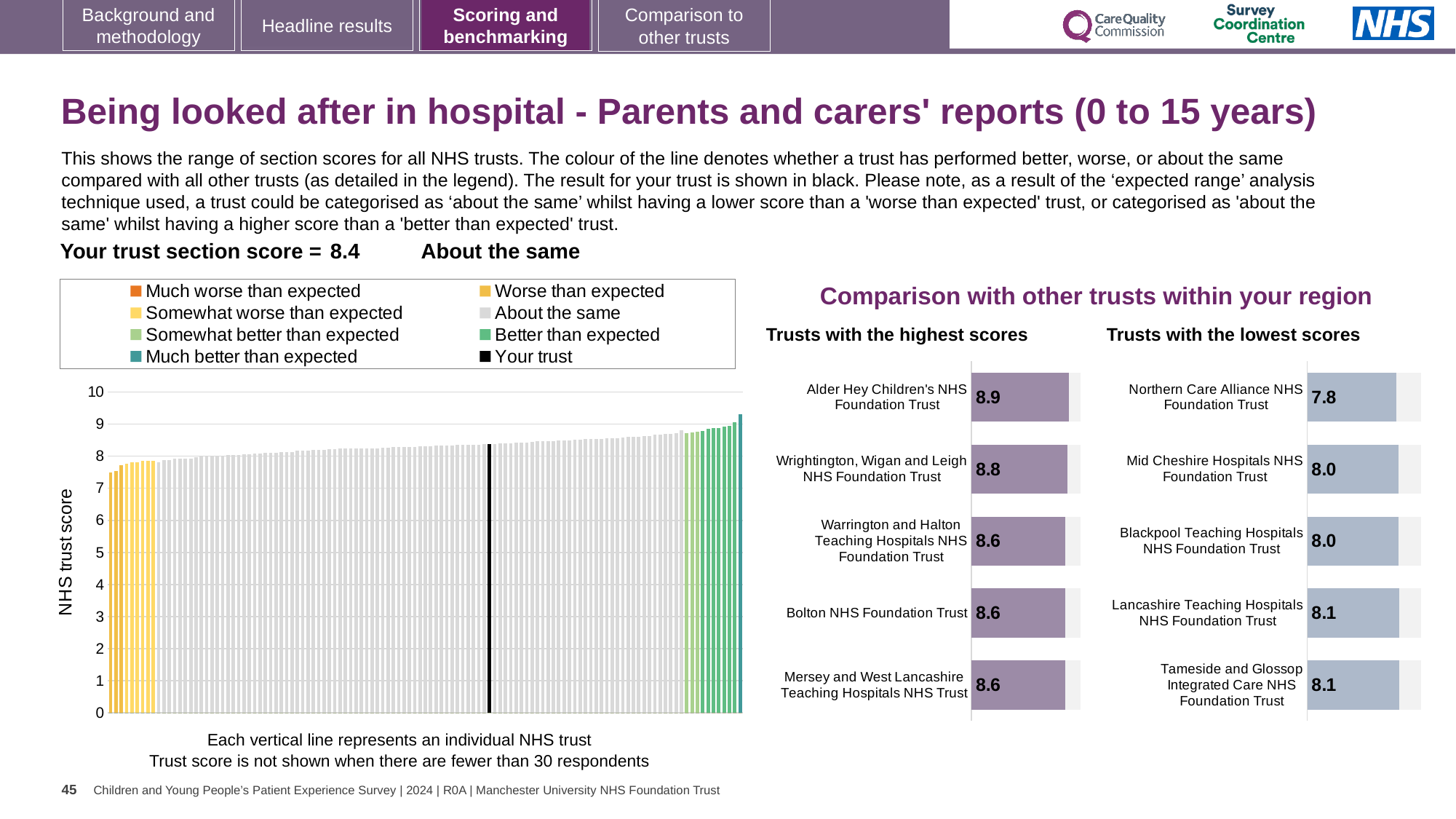
In the 'Trusts with the lowest scores' chart, what is the score for Northern Care Alliance NHS Foundation Trust? 7.8 In the main NHS trust score chart on the left, what is the section score for your trust (shown in black)? 8.4 What kind of chart is the main NHS trust score chart on the left of the slide? Bar chart How many entries does the legend of the main NHS trust score chart on the left list? 8 In the 'Trusts with the lowest scores' chart, which trust has the lowest score? Northern Care Alliance NHS Foundation Trust In the 'Trusts with the highest scores' chart, what is the score for Alder Hey Children's NHS Foundation Trust? 8.9 In the 'Trusts with the highest scores' chart, which has the larger score: Wrightington, Wigan and Leigh NHS Foundation Trust or Bolton NHS Foundation Trust? Wrightington, Wigan and Leigh NHS Foundation Trust In the 'Trusts with the highest scores' chart, what is the difference between the scores of Alder Hey Children's NHS Foundation Trust and Wrightington, Wigan and Leigh NHS Foundation Trust? 0.1 In the 'Trusts with the highest scores' chart, which trust has the highest score? Alder Hey Children's NHS Foundation Trust In the main NHS trust score chart on the left, do the values rise or fall from left to right? Rise How many trusts are shown in the 'Trusts with the highest scores' chart? 5 What is the difference between the score of Alder Hey Children's NHS Foundation Trust in the highest scores chart and Northern Care Alliance NHS Foundation Trust in the lowest scores chart? 1.1